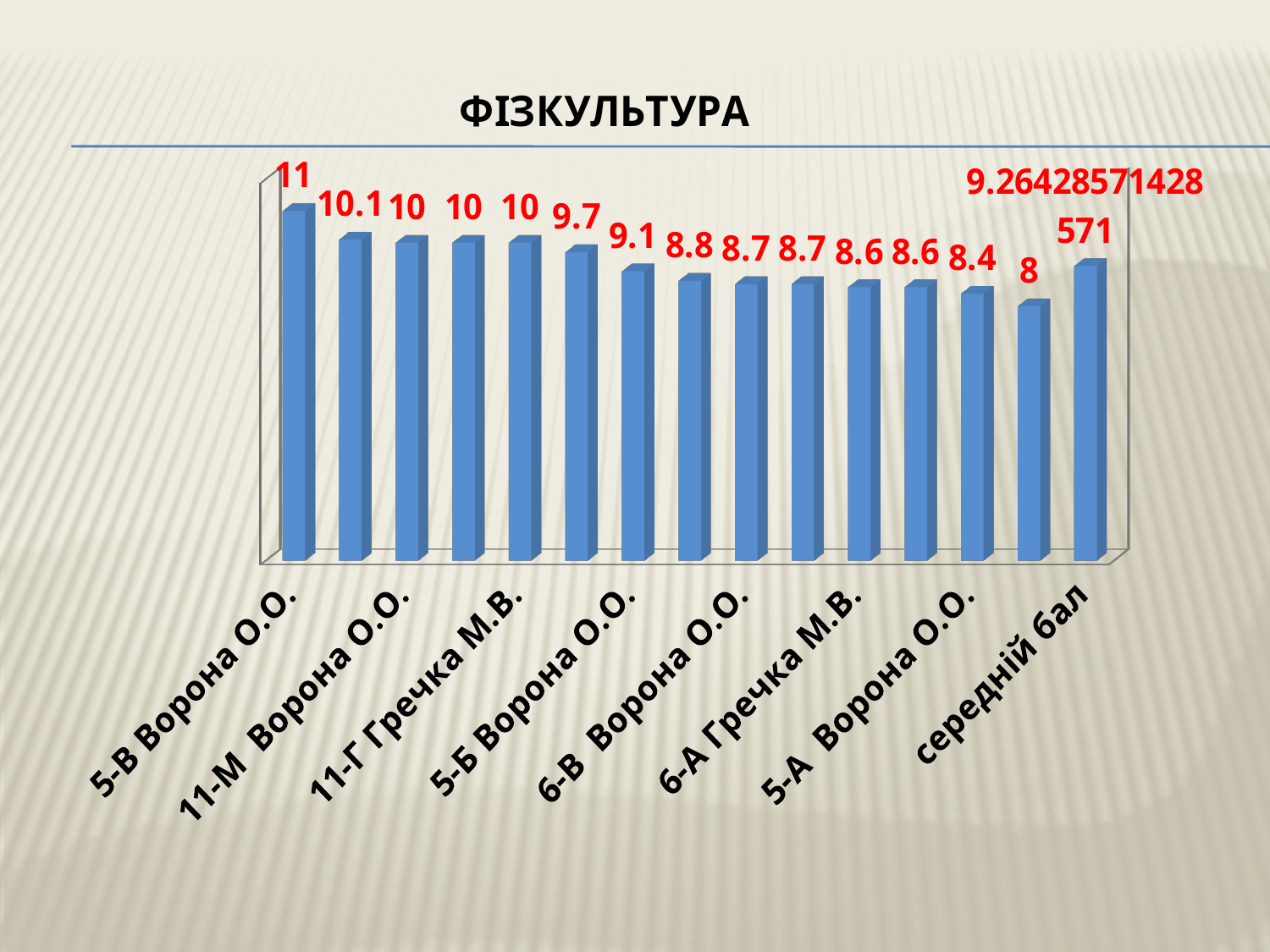
What is the value for середній бал? 9.26428571428571 Do the values of the bars generally rise or fall from left to right before the final середній бал bar? fall What is the lowest value shown on any bar? 8 What is the value for 5-Б Ворона О.О.? 9.1 What is the value for 5-В Ворона О.О.? 11 What kind of chart is shown on the slide? bar chart What is the difference between the highest bar value (11) and the lowest bar value (8)? 3 Which category has the highest value? 5-В Ворона О.О. What is the value for 5-А Ворона О.О.? 8.4 How many bars are plotted in the chart? 15 What is the title of the chart? ФІЗКУЛЬТУРА Which is larger, the value for 5-В Ворона О.О. or the value for 5-А Ворона О.О.? 5-В Ворона О.О.